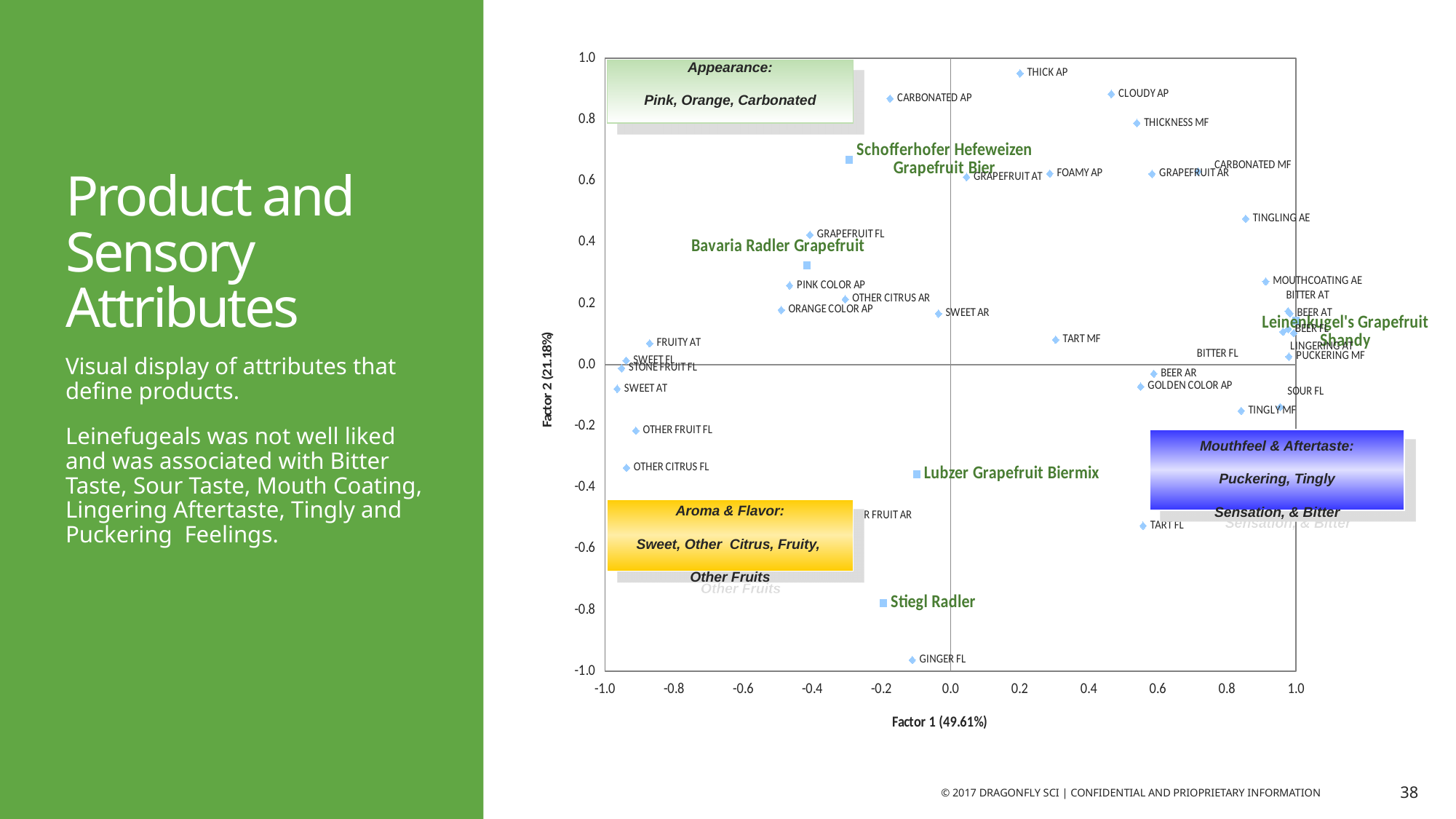
Is the Factor 2 value for Stiegl Radler greater or less than -0.6? less What is the label of the vertical axis of the chart? Factor 2 (21.18%) What is the label of the horizontal axis of the chart? Factor 1 (49.61%) How many products (square markers) are labeled on the chart? 5 Which product has the higher Factor 1 value, Stiegl Radler or Leinenkugel's Grapefruit Shandy? Leinenkugel's Grapefruit Shandy Is the Factor 1 value for Leinenkugel's Grapefruit Shandy greater or less than 0.8? greater Is the Factor 2 value for THICK AP greater or less than 0.8? greater Which labeled point has the lowest Factor 2 value? GINGER FL What kind of chart is shown on the slide? scatter chart Which product has the higher Factor 2 value, Schofferhofer Hefeweizen Grapefruit Bier or Bavaria Radler Grapefruit? Schofferhofer Hefeweizen Grapefruit Bier